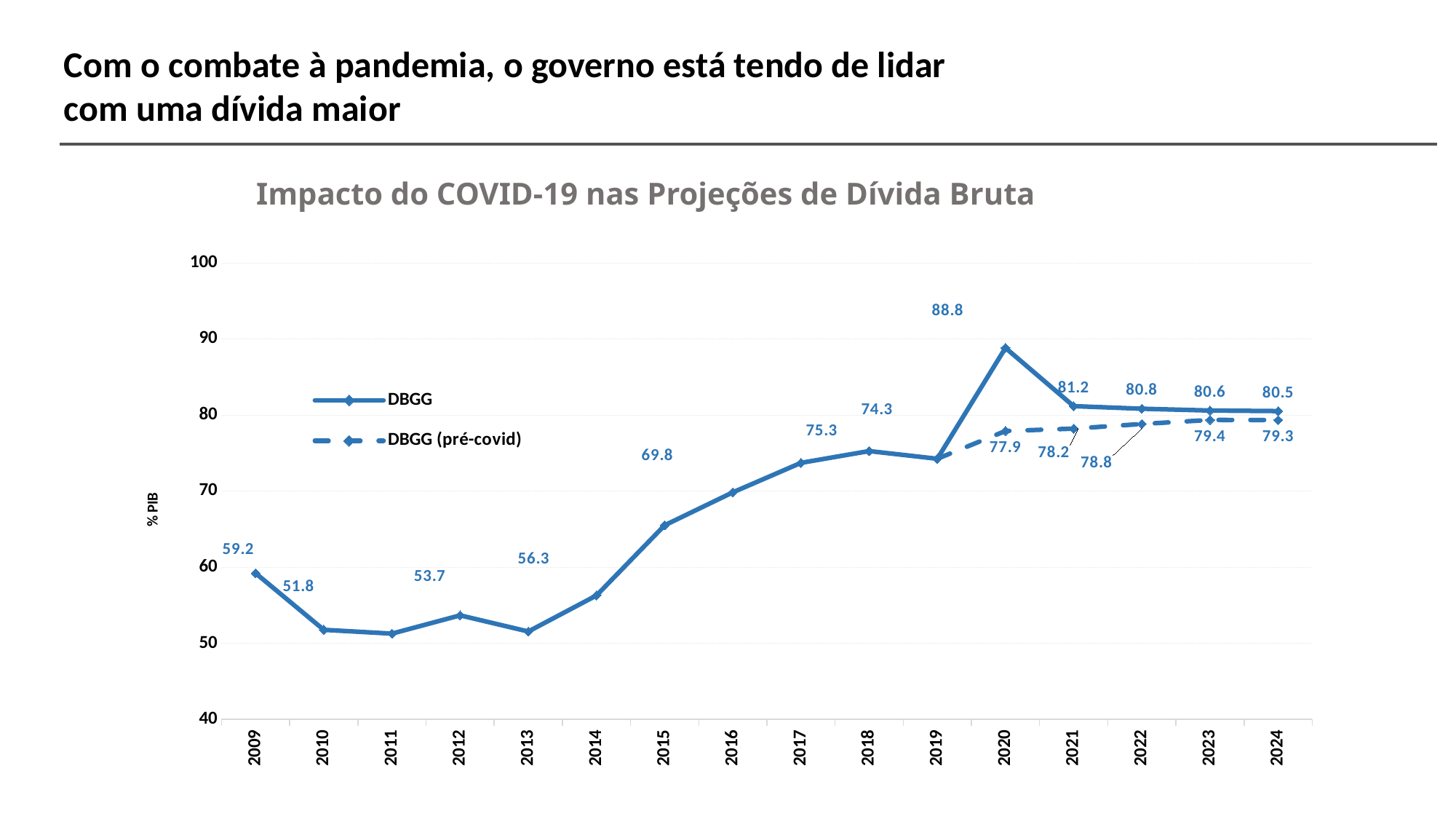
What is the difference between DBGG and DBGG (pré-covid) in 2020? 10.9 In which year does the DBGG series reach its highest value? 2020 Is the DBGG value for 2013 greater or less than 60? less In 2021, which series has the larger value, DBGG or DBGG (pré-covid)? DBGG What kind of chart is shown on the slide? line chart What is the difference between DBGG and DBGG (pré-covid) in 2024? 1.2 How many years are shown on the x axis? 16 What is the DBGG (pré-covid) value for 2024? 79.3 What is the DBGG value for 2020? 88.8 How many series does the legend list? 2 What is the DBGG value for 2009? 59.2 Does the DBGG series rise or fall from 2021 to 2024? fall